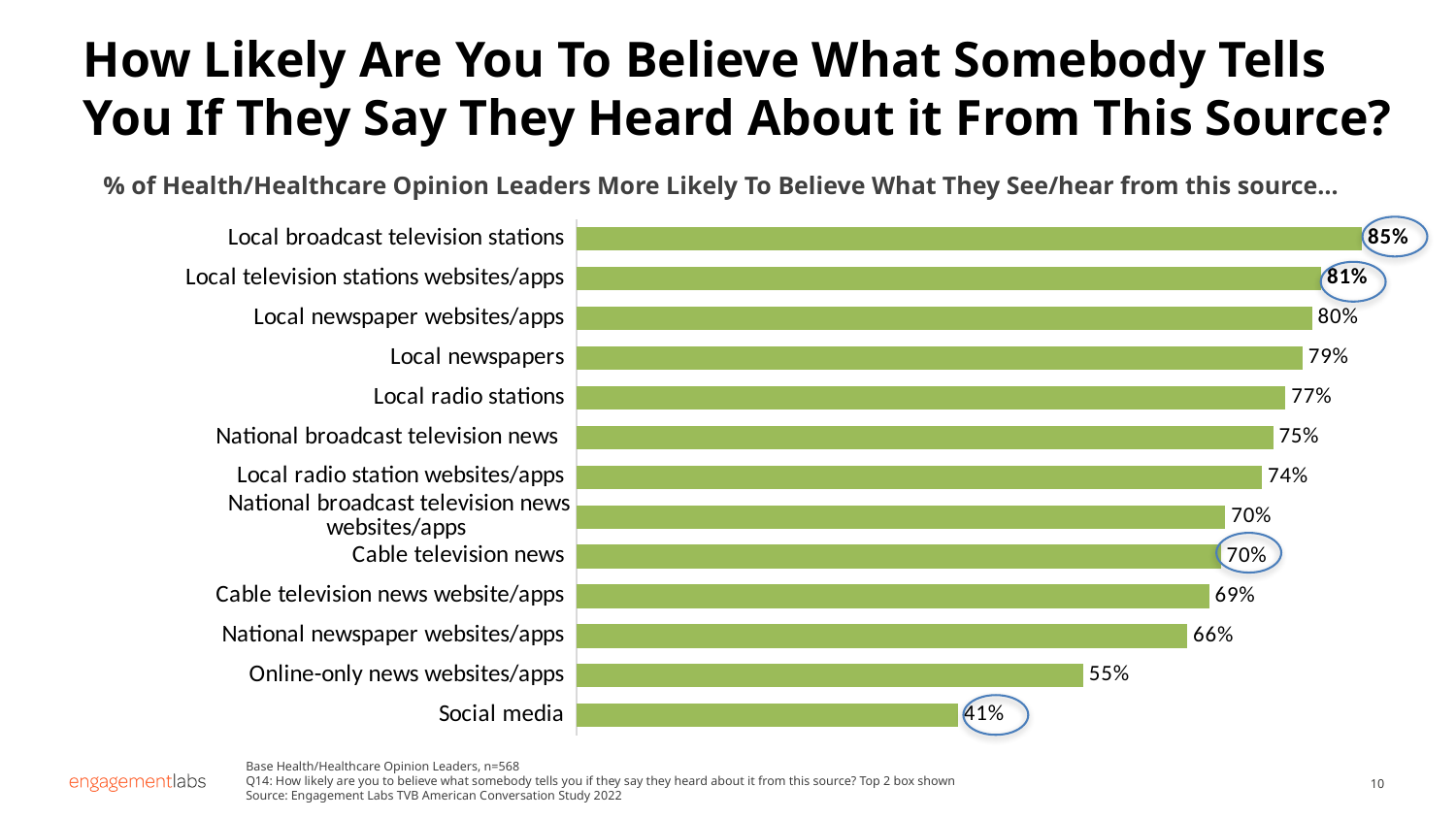
What is the value shown for Local radio stations? 77% What is the value shown for Online-only news websites/apps? 55% Which has a higher value: National broadcast television news or National newspaper websites/apps? National broadcast television news Which source has the lowest percentage? Social media What type of chart is shown on the slide? Bar chart What colour are the bars in the chart? Green What is the difference between the values for Local newspapers and Cable television news? 9 percentage points How many sources are shown in the chart? 13 What is the value shown for Social media? 41% What percentage of Health/Healthcare Opinion Leaders are more likely to believe what they hear from Local broadcast television stations? 85% Which source has the highest percentage? Local broadcast television stations What is the difference between the values for Local broadcast television stations and Social media? 44 percentage points